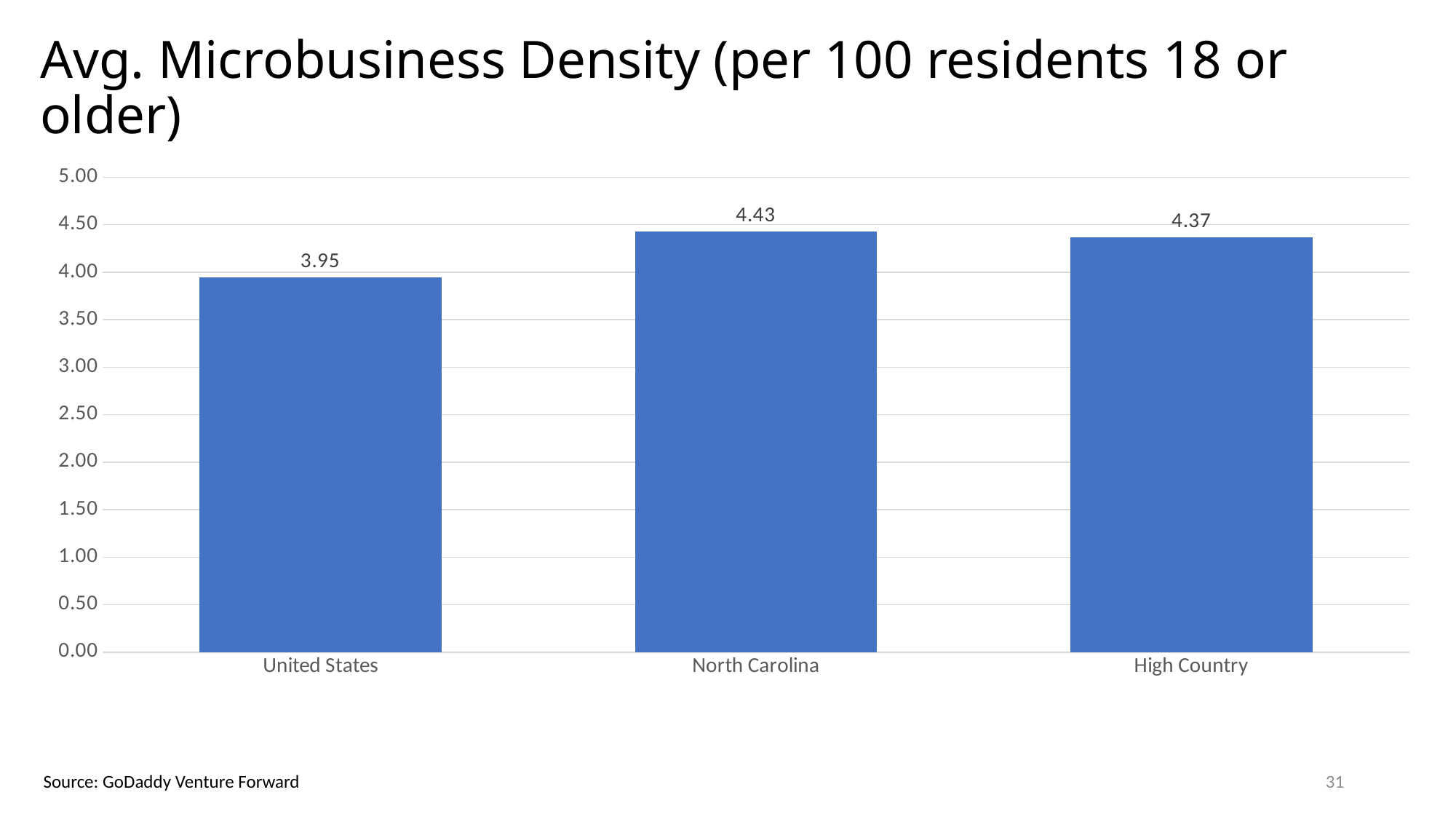
Which is larger, the value for High Country or the value for the United States? High Country What is the average microbusiness density for High Country? 4.37 What is the difference between the North Carolina and United States values? 0.48 What is the average microbusiness density for the United States? 3.95 Which category has the highest average microbusiness density? North Carolina What is the difference between the North Carolina and High Country values? 0.06 How many categories are shown in the chart? 3 What kind of chart is shown on the slide? bar chart What source is cited for the chart data? GoDaddy Venture Forward Which category has the lowest average microbusiness density? United States Is the value for the United States greater or less than 4.00? less What is the average microbusiness density for North Carolina? 4.43